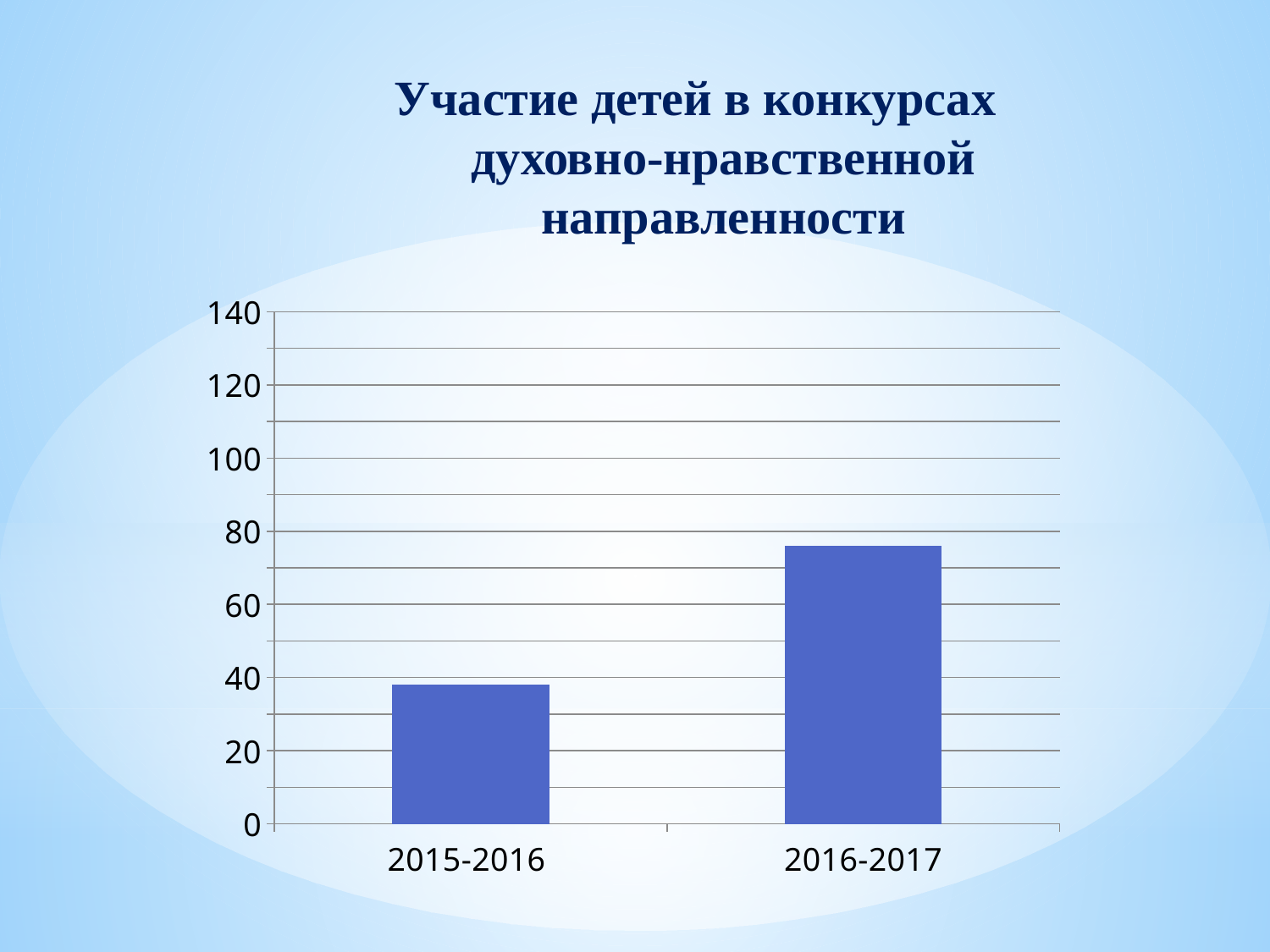
How many categories are plotted on the x axis? 2 What is the title of the chart? Участие детей в конкурсах духовно-нравственной направленности Which category has the lowest value? 2015-2016 Is the value for 2016-2017 greater or less than 60? greater What is the highest value shown on the vertical axis? 140 Is the value for 2015-2016 greater or less than 20? greater What kind of chart is shown on the slide? bar chart Is the value for 2016-2017 greater or less than 80? less Which is larger, the value for 2015-2016 or the value for 2016-2017? 2016-2017 Do the values rise or fall from 2015-2016 to 2016-2017? rise Which category has the highest value? 2016-2017